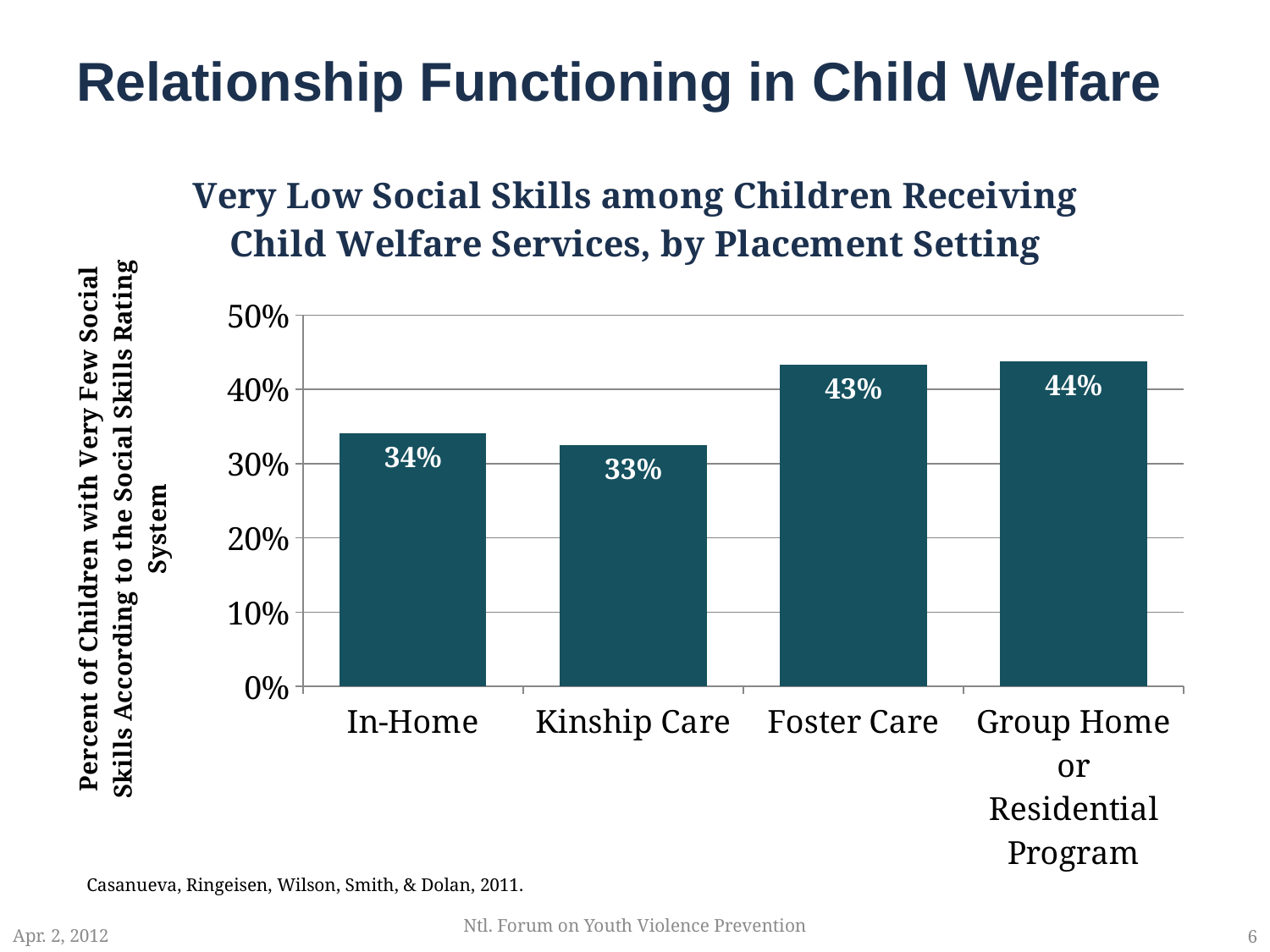
Which placement setting has the lowest percentage of children with very low social skills? Kinship Care What is the value for Group Home or Residential Program? 44% How many placement settings are shown in the chart? 4 What is the value for In-Home? 34% Which is larger, the value for Foster Care or the value for In-Home? Foster Care What is the difference between the values for Foster Care and Kinship Care? 10% Is the value for Foster Care greater or less than 40%? greater What is the title of the chart? Very Low Social Skills among Children Receiving Child Welfare Services, by Placement Setting What kind of chart is shown on the slide? Bar chart Which placement setting has the highest percentage of children with very low social skills? Group Home or Residential Program What is the value for Foster Care? 43% What is the value for Kinship Care? 33%